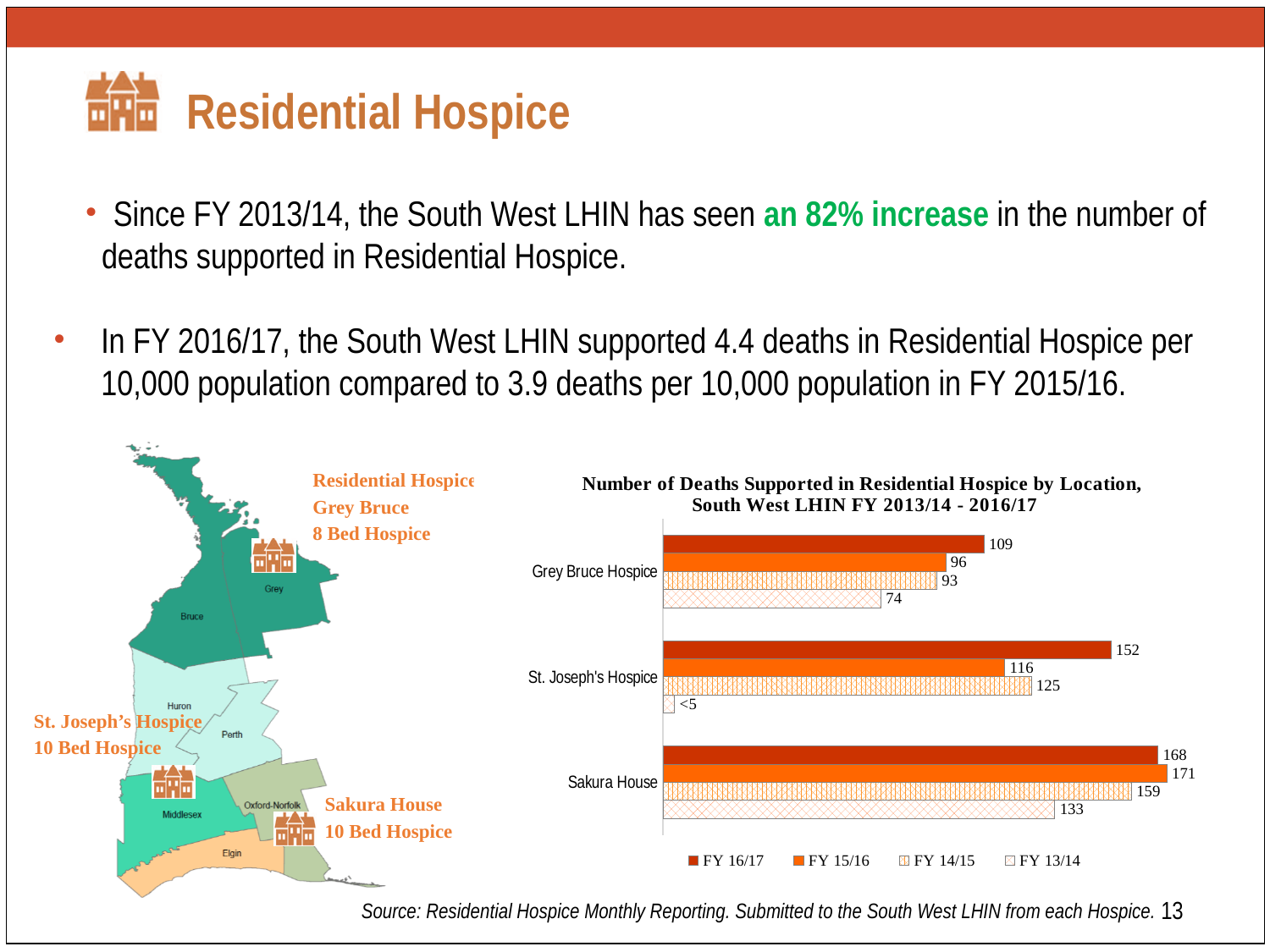
What is the number of deaths supported at St. Joseph's Hospice in FY 14/15? 125 What value is shown for St. Joseph's Hospice in FY 13/14? <5 What kind of chart is shown on the slide? Bar chart What is the difference between the FY 16/17 and FY 13/14 values for Grey Bruce Hospice? 35 What is the number of deaths supported at Sakura House in FY 13/14? 133 Which location had the highest number of deaths supported in FY 16/17? Sakura House How many hospice locations are shown on the chart? 3 What is the title of the chart? Number of Deaths Supported in Residential Hospice by Location, South West LHIN FY 2013/14 - 2016/17 How many series does the legend of the chart list? 4 For Sakura House, which is larger: the FY 16/17 value or the FY 15/16 value? FY 15/16 Which location had the lowest number of deaths supported in FY 15/16? Grey Bruce Hospice What is the number of deaths supported at Grey Bruce Hospice in FY 16/17? 109